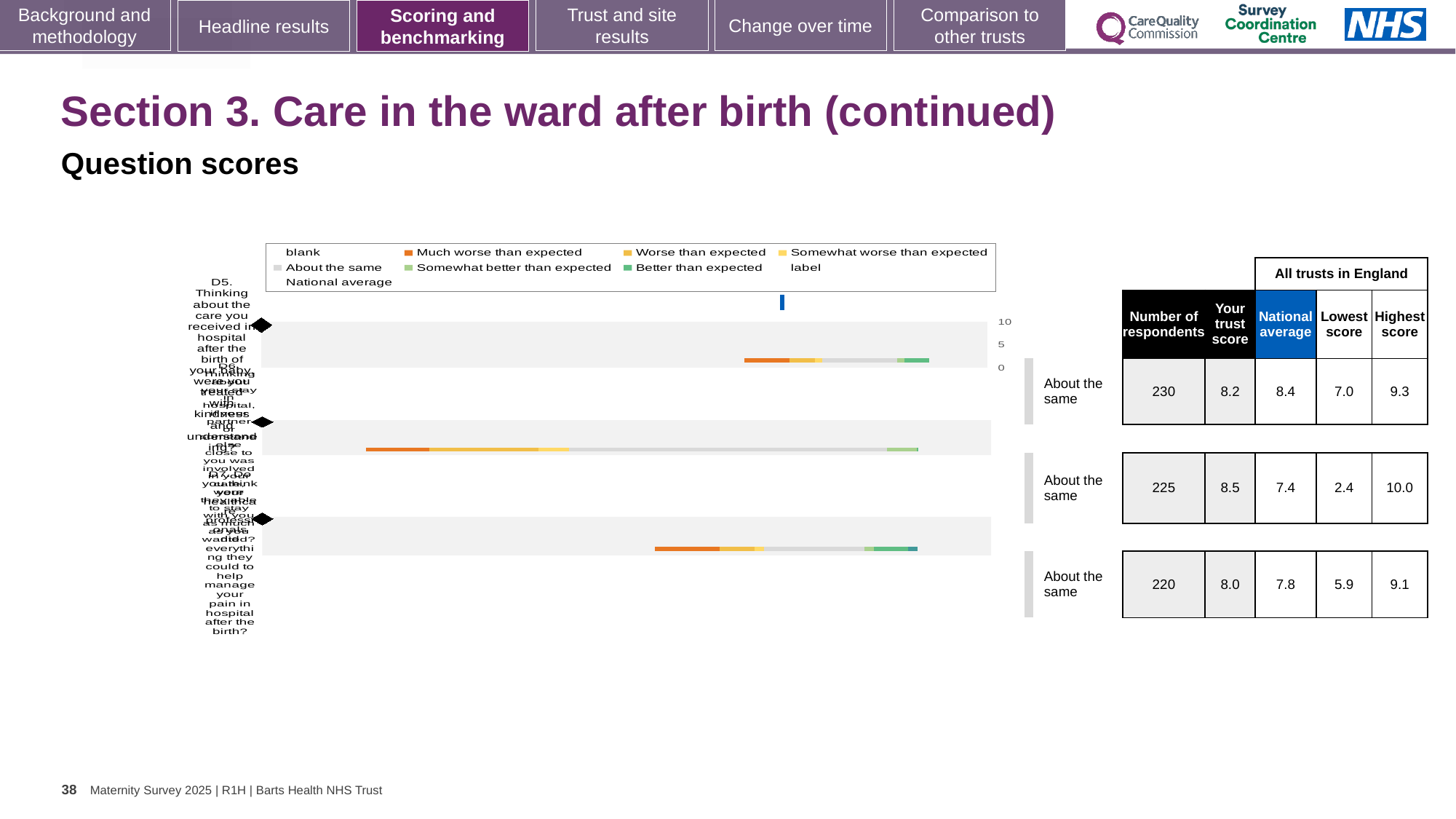
In the table beside the chart, what is the trust score for the second question row? 8.5 In the table beside the chart, what is the lowest score for the second question row? 2.4 Which legend entry is shown in orange in the chart's legend? Much worse than expected In the table beside the chart, is the trust score for the first question row larger or smaller than its national average? smaller What kind of chart is shown on the slide? bar chart In the table beside the chart, what is the number of respondents for the first question row? 230 What is the highest tick value shown on the chart's axis? 10 How many question rows (bars) are plotted in the chart? 3 In the table beside the chart, which question row has the lowest number of respondents? the third row (220) In the table beside the chart, what is the national average for the third question row? 7.8 In the table beside the chart, which question row has the highest trust score? the second row (8.5) In the table beside the chart, what is the difference between the highest score and the lowest score for the first question row? 2.3